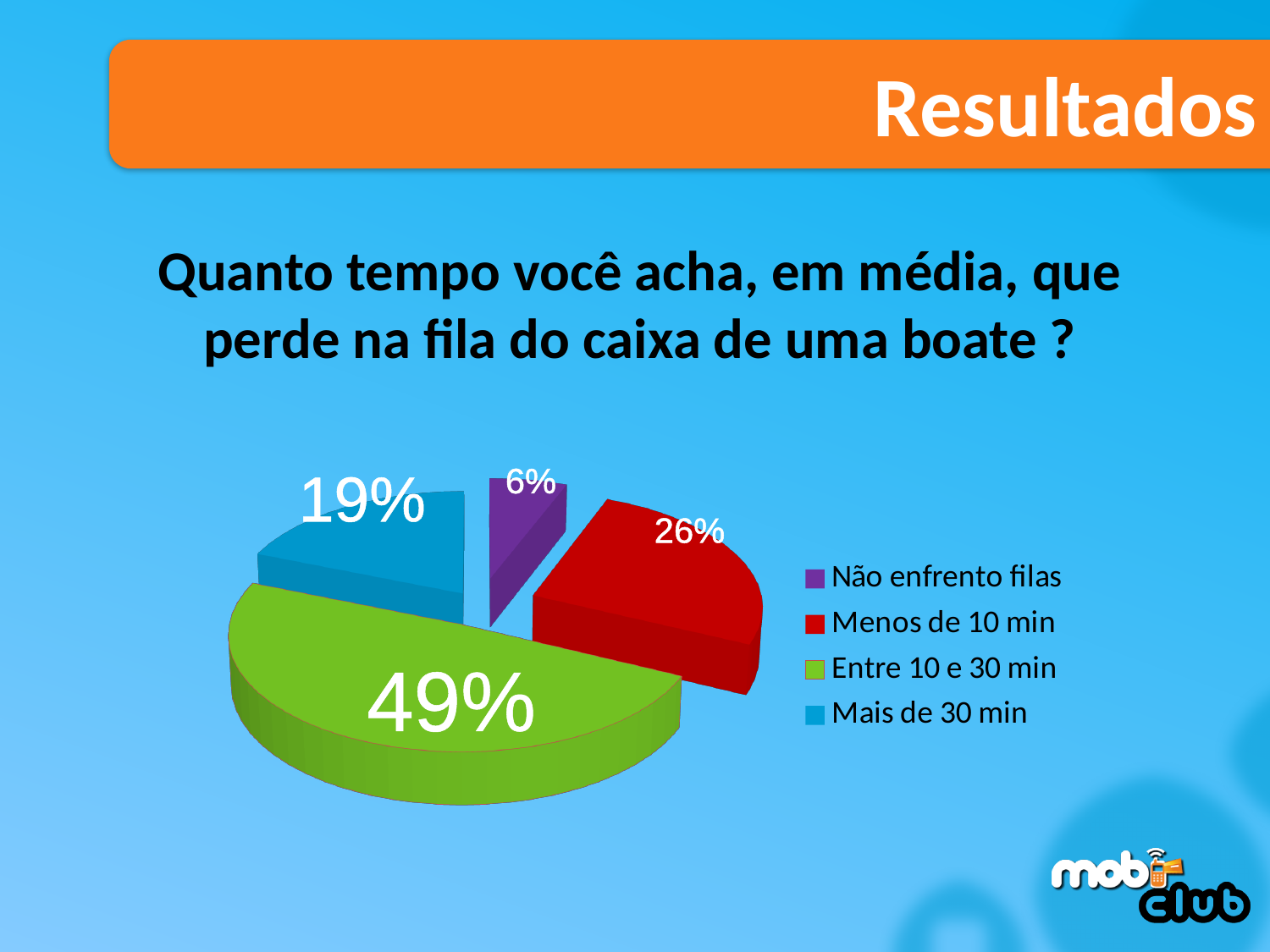
What share of the pie does "Entre 10 e 30 min" have? 49% What share of the pie does "Não enfrento filas" have? 6% Which is larger, the slice for "Menos de 10 min" or the slice for "Mais de 30 min"? Menos de 10 min How many categories does the pie chart show? 4 What share of the pie does "Menos de 10 min" have? 26% What colour is the slice for "Mais de 30 min"? Blue What kind of chart is shown on the slide? Pie chart What is the difference in percentage points between "Entre 10 e 30 min" and "Menos de 10 min"? 23 Which category has the smallest slice of the pie? Não enfrento filas What is the difference in percentage points between "Mais de 30 min" and "Não enfrento filas"? 13 Which category has the largest slice of the pie? Entre 10 e 30 min